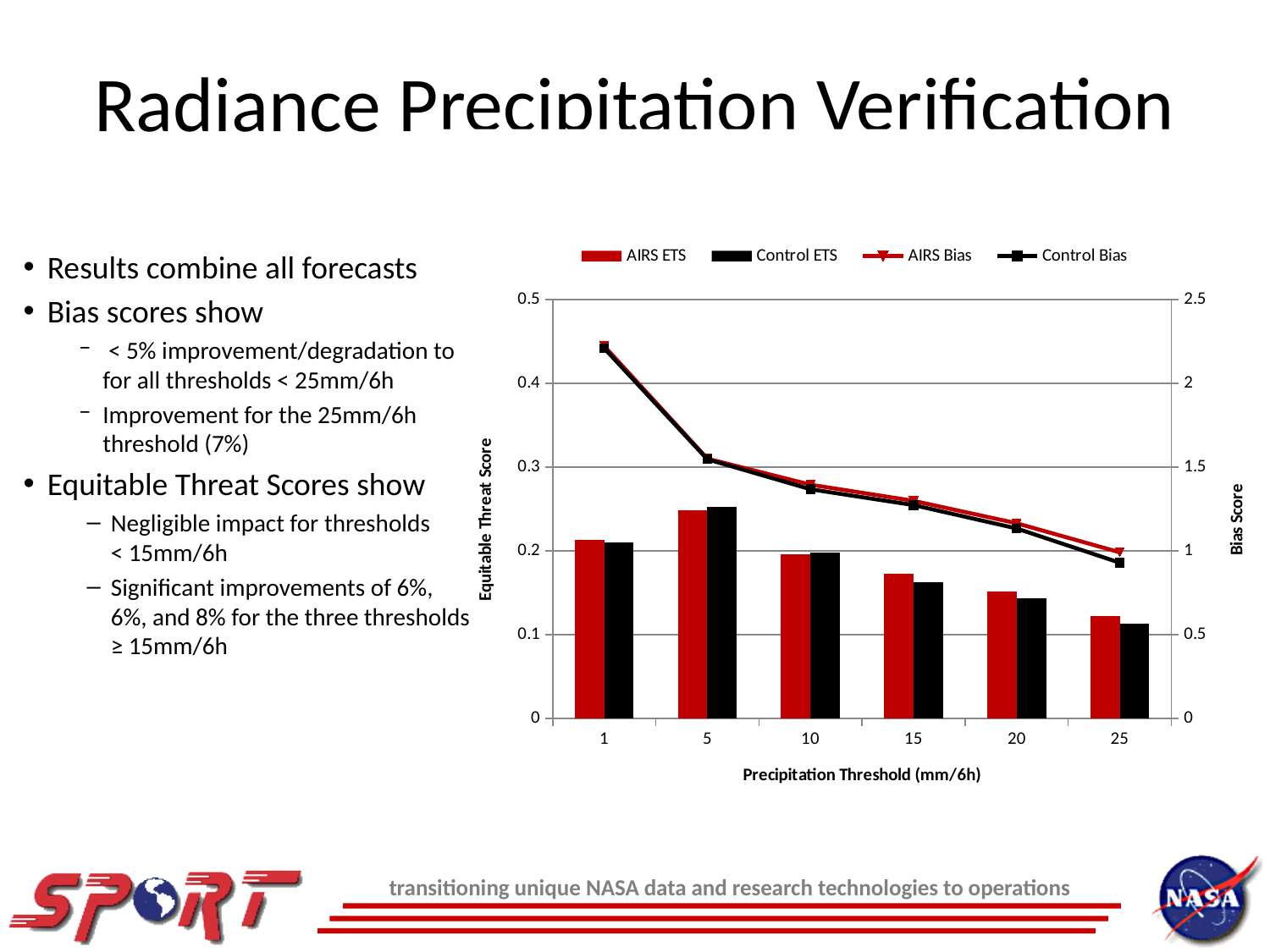
Is the Control Bias value at the 25 mm/6h threshold greater or less than 1? less How many series does the chart legend list? 4 Is the Control ETS value at the 20 mm/6h threshold greater or less than 0.2? less What kind of chart is shown on the slide? A combination bar and line chart At which precipitation threshold is the AIRS ETS bar lowest? 25 At the 15 mm/6h threshold, which is larger: AIRS ETS or Control ETS? AIRS ETS At which precipitation threshold is the AIRS ETS bar highest? 5 What is the title of the x axis of the chart? Precipitation Threshold (mm/6h) Is the AIRS Bias value at the 1 mm/6h threshold greater or less than 2? greater Do the bias score lines rise or fall as the precipitation threshold increases? Fall How many precipitation threshold categories are shown on the x axis? 6